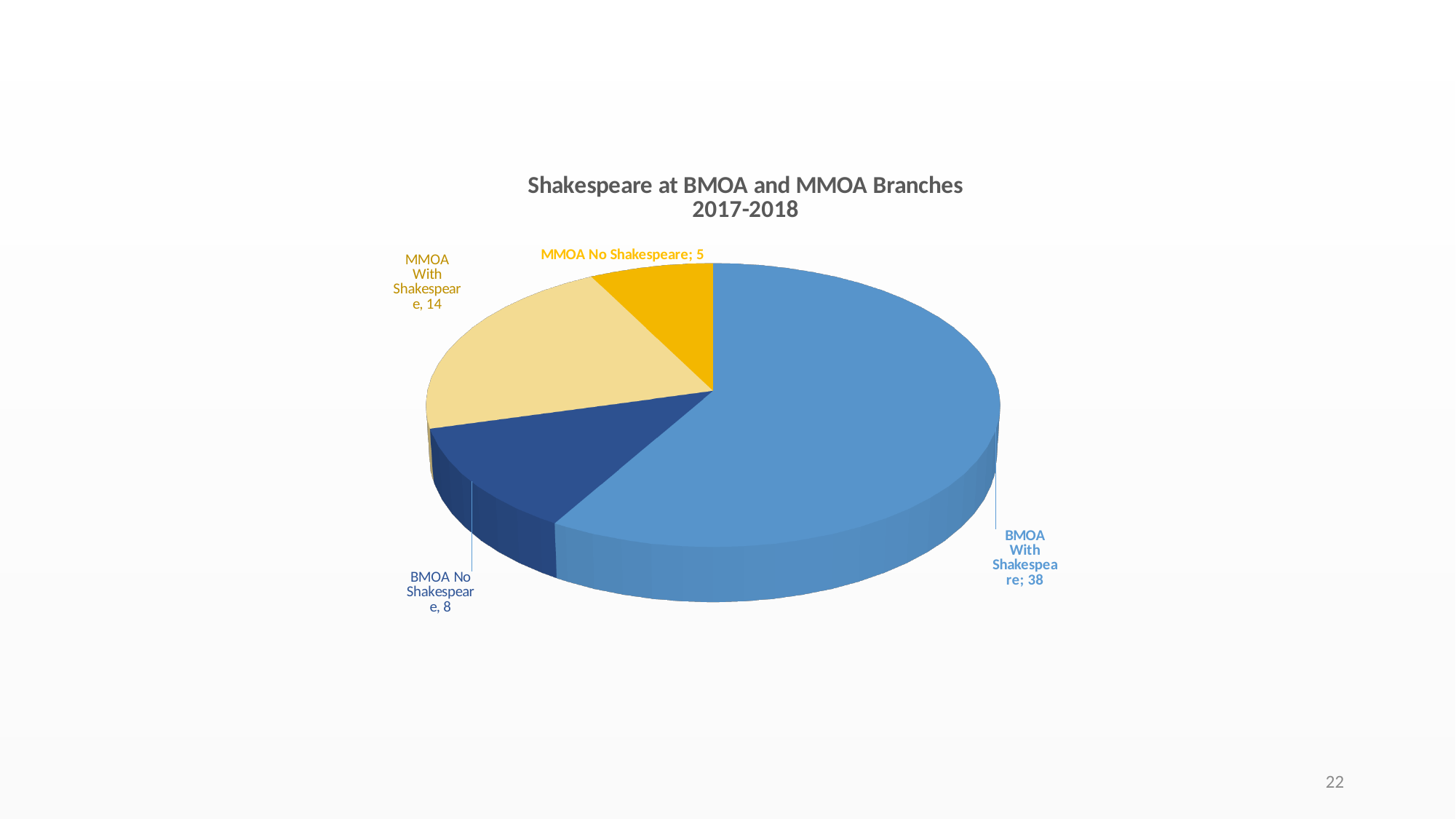
What is the value for BMOA With Shakespeare? 38 Which category has the smallest slice? MMOA No Shakespeare Which category has the largest slice? BMOA With Shakespeare What is the value for MMOA With Shakespeare? 14 What is the value for MMOA No Shakespeare? 5 What is the title of the chart? Shakespeare at BMOA and MMOA Branches 2017-2018 What is the total of all four slices in the pie chart? 65 What type of chart is shown on the slide? Pie chart How many slices does the pie chart have? 4 Which is larger, BMOA No Shakespeare or MMOA With Shakespeare? MMOA With Shakespeare What is the value for BMOA No Shakespeare? 8 What is the difference between BMOA With Shakespeare and MMOA With Shakespeare? 24